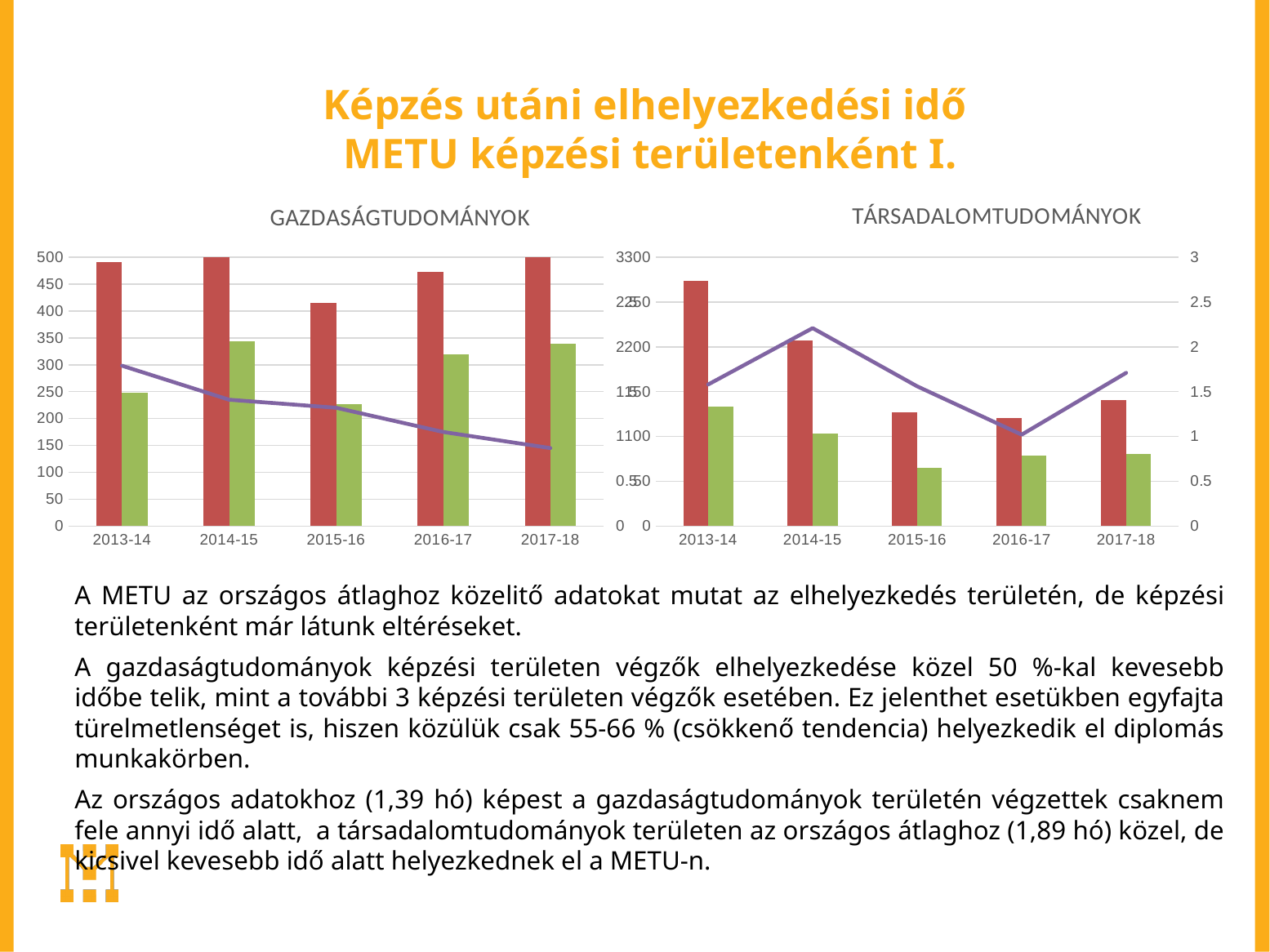
In the GAZDASÁGTUDOMÁNYOK chart, is the green bar for 2013-14 greater or less than 300? less In the TÁRSADALOMTUDOMÁNYOK chart, which year has the highest red bar? 2013-14 In the GAZDASÁGTUDOMÁNYOK chart, is the purple line value for 2017-18 greater or less than 200? less What is the title of the chart on the left side of the slide? GAZDASÁGTUDOMÁNYOK In the TÁRSADALOMTUDOMÁNYOK chart, is the purple line value for 2014-15 greater or less than 2 on the right-hand axis? greater In the GAZDASÁGTUDOMÁNYOK chart, which year has the lowest red bar? 2015-16 How many categories (academic years) are shown on the x axis of the GAZDASÁGTUDOMÁNYOK chart? 5 In the GAZDASÁGTUDOMÁNYOK chart, does the purple line rise or fall from 2013-14 to 2017-18? Fall In the GAZDASÁGTUDOMÁNYOK chart, which is larger for 2013-14, the red bar or the green bar? The red bar What kind of chart is the TÁRSADALOMTUDOMÁNYOK chart? Bar chart with a line In the TÁRSADALOMTUDOMÁNYOK chart, which year has the lowest green bar? 2015-16